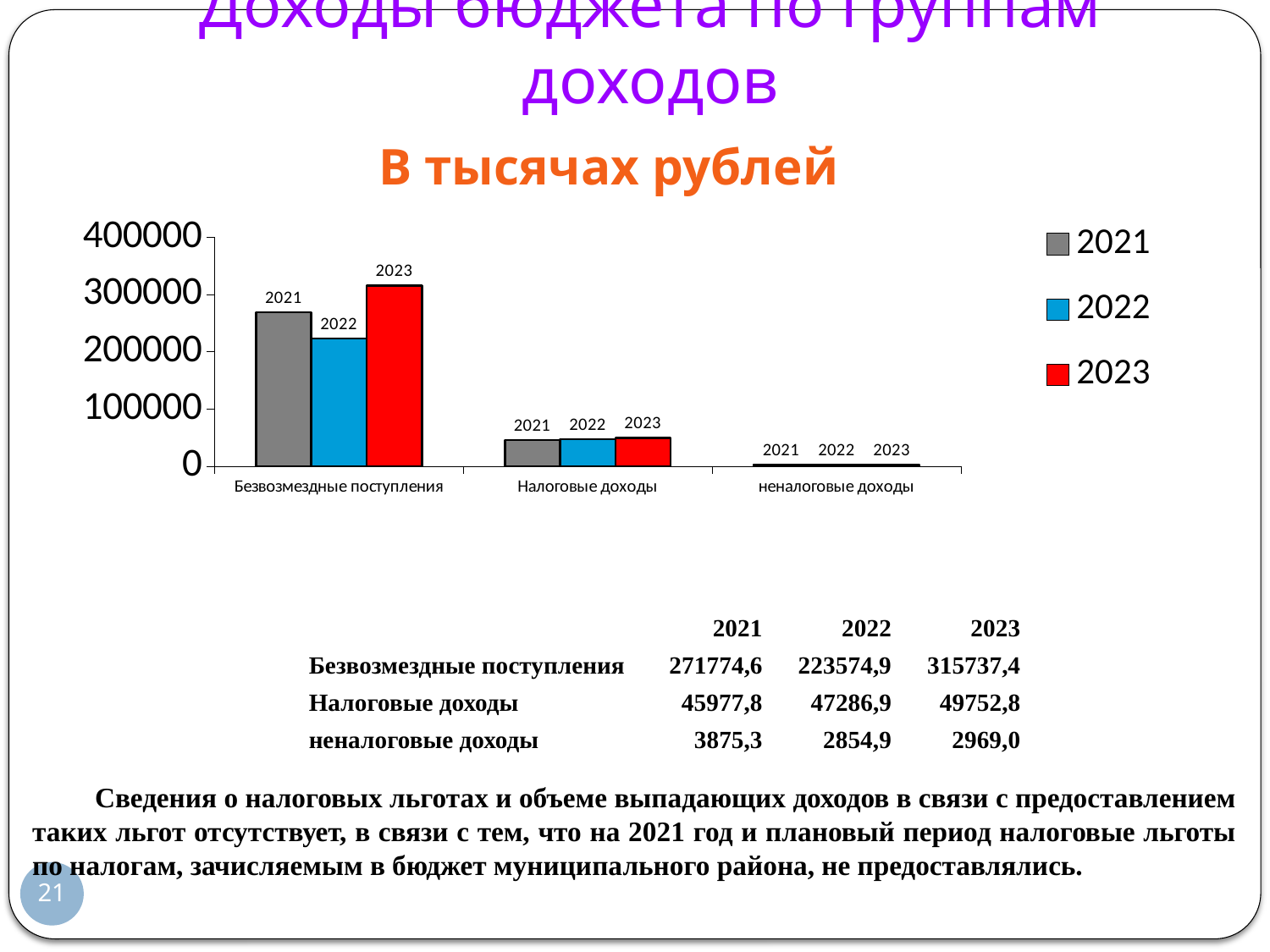
What is the difference between the 2023 and 2022 values for Безвозмездные поступления? 92162,5 Which is larger for Безвозмездные поступления: the 2021 value or the 2022 value? 2021 What is the value for неналоговые доходы in 2021? 3875,3 Which category has the highest value in 2023? Безвозмездные поступления How many categories are shown on the x axis of the chart? 3 How many series does the chart legend list? 3 What is the value for Безвозмездные поступления in 2023? 315737,4 What is the value for Налоговые доходы in 2022? 47286,9 Do the values for Налоговые доходы rise or fall from 2021 to 2023? rise Is the value for Безвозмездные поступления in 2023 greater or less than 300000? greater Which category has the lowest value in 2021? неналоговые доходы What kind of chart is shown on the slide? bar chart